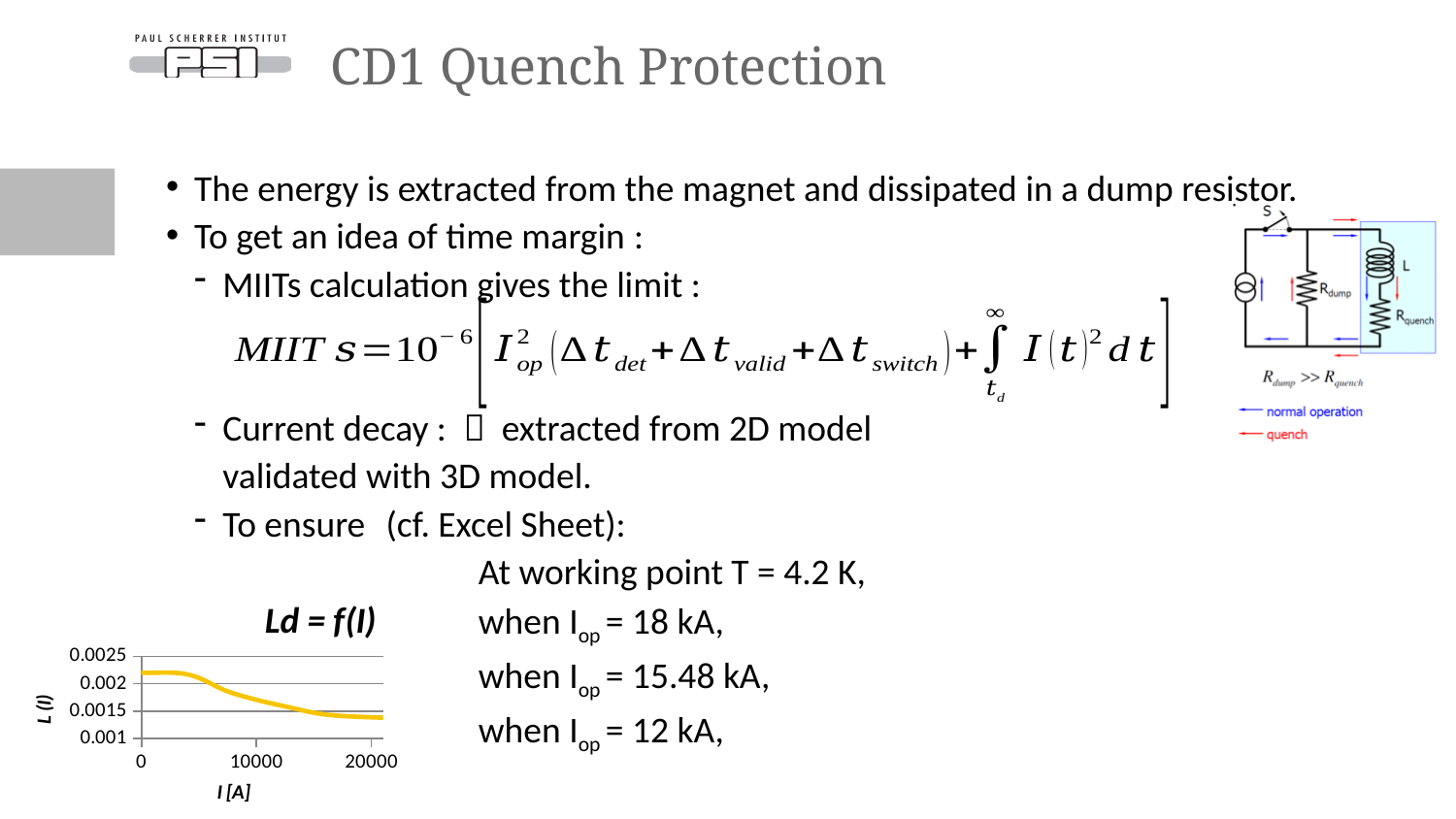
In the Ld = f(I) chart, is L(I) larger at I = 0 A or at I = 20000 A? I = 0 A In the Ld = f(I) chart, does L(I) rise or fall as I increases along the x axis? fall What is the highest tick value shown on the y axis of the Ld = f(I) chart? 0.0025 What is the lowest tick value shown on the y axis of the Ld = f(I) chart? 0.001 In the Ld = f(I) chart, is the value of L(I) at I = 0 A greater or less than 0.0025? less What is the title of the chart on the slide? Ld = f(I) What is the highest tick value shown on the x axis of the Ld = f(I) chart? 20000 In the Ld = f(I) chart, is the value of L(I) at I = 0 A greater or less than 0.0015? greater What is the label of the x axis of the Ld = f(I) chart? I [A] In the Ld = f(I) chart, is the value of L(I) at I = 20000 A greater or less than 0.0015? less What kind of chart is the Ld = f(I) chart? line chart